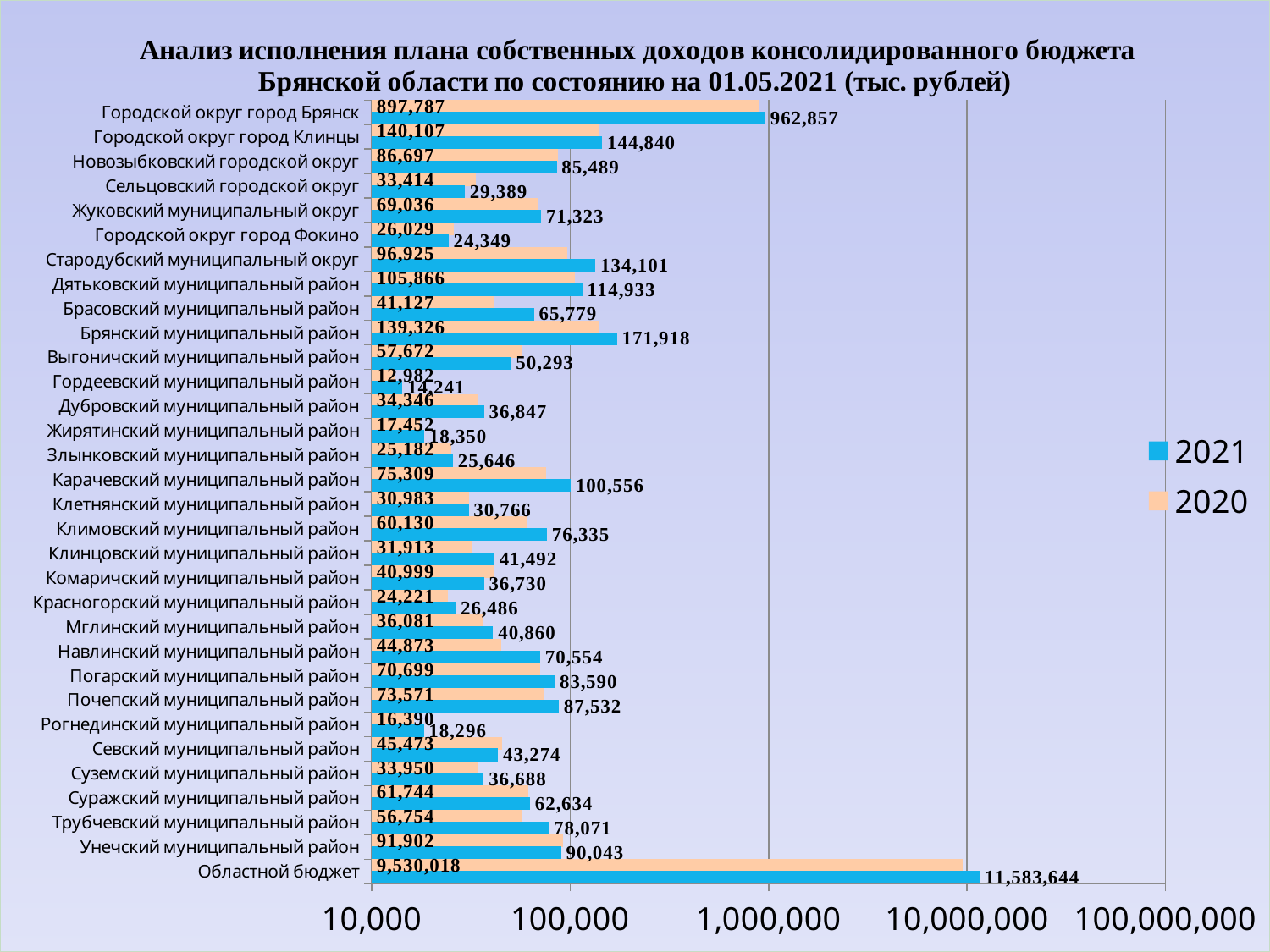
Which category has the highest 2021 value? Областной бюджет What is the 2021 value for Брянский муниципальный район? 171,918 What kind of chart is shown on the slide? Bar chart What is the 2021 value for Городской округ город Брянск? 962,857 Which is larger for Комаричский муниципальный район, the 2021 value or the 2020 value? 2020 Which colour represents the 2020 series in the legend? Peach (light orange) How many categories are shown on the chart? 32 What is the difference between the 2021 and 2020 values for Стародубский муниципальный округ? 37,176 What is the 2020 value for Областной бюджет? 9,530,018 Which category has the lowest 2020 value? Гордеевский муниципальный район What is the 2020 value for Карачевский муниципальный район? 75,309 How many series does the legend list? 2